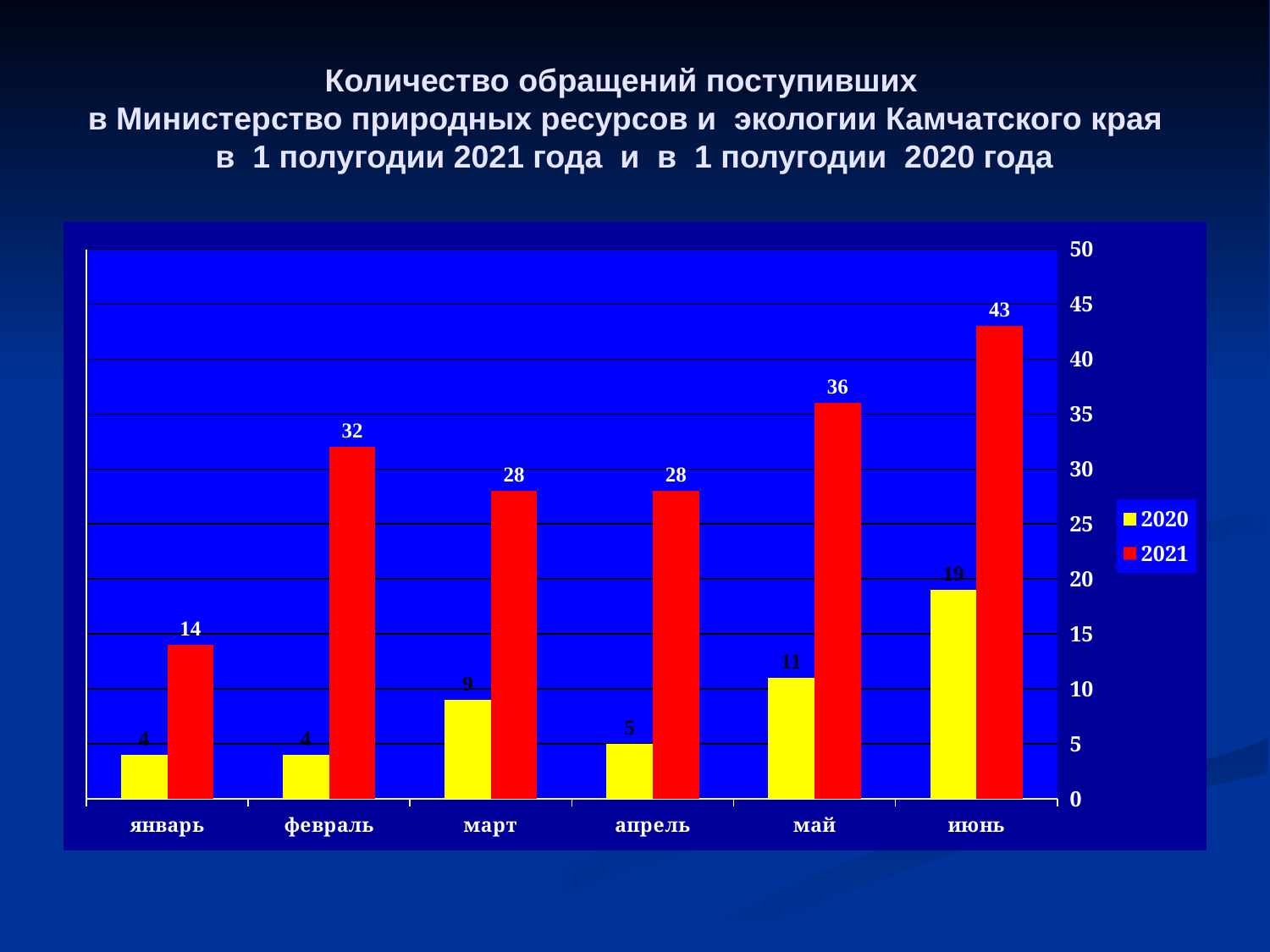
Which is larger in март: the 2020 value or the 2021 value? 2021 Do the 2021 values rise or fall from апрель to июнь? rise Which month has the lowest value for the 2021 series? январь What is the value for 2021 in июнь? 43 Which colour represents the 2020 series? yellow What kind of chart is shown on the slide? bar chart How many months are shown on the x axis? 6 How many series does the legend list? 2 What is the value for 2020 in май? 11 What is the difference between the 2021 and 2020 values in февраль? 28 What is the value for 2021 in январь? 14 Which month has the highest value for the 2021 series? июнь